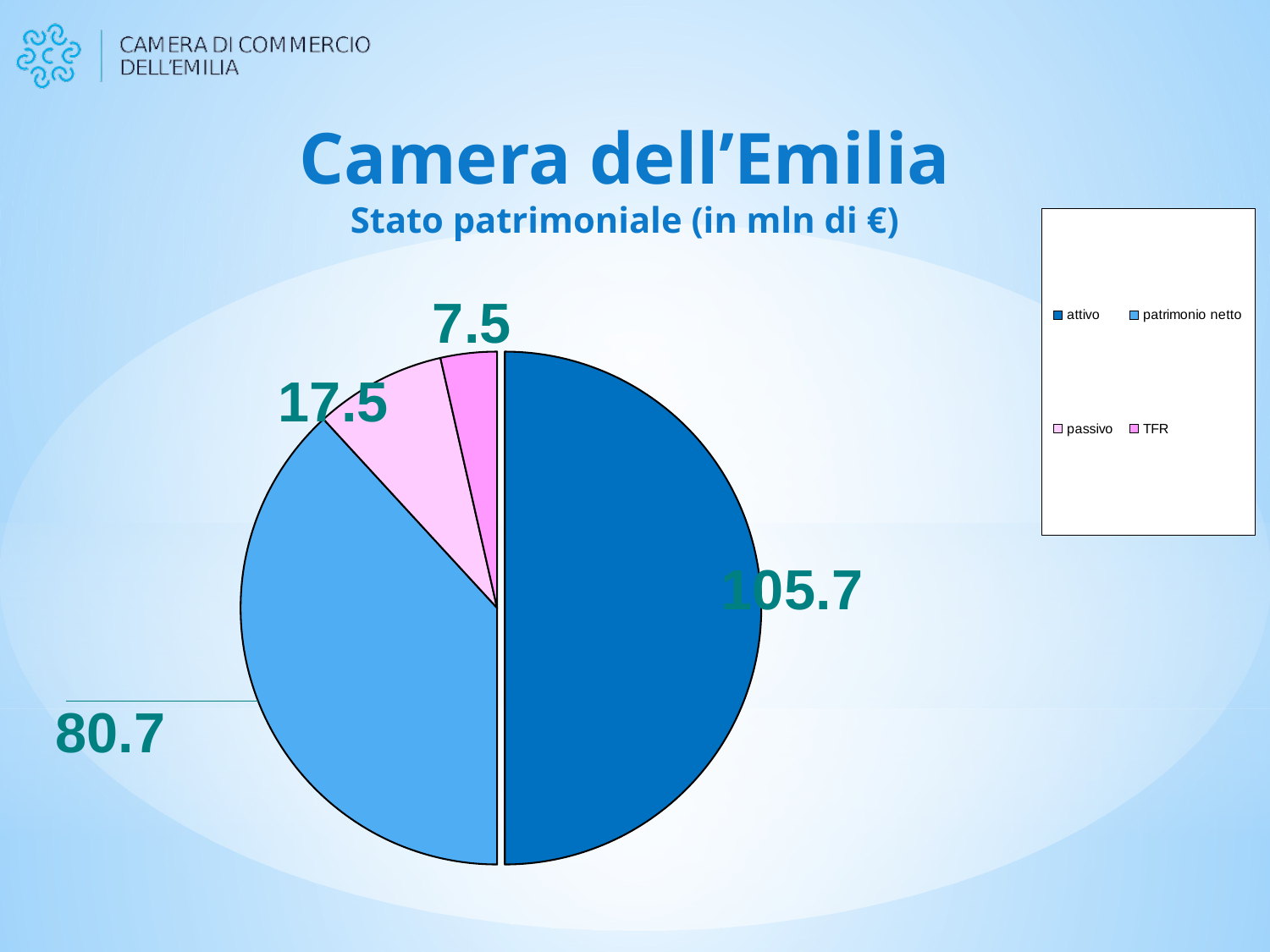
What is the difference between the values for attivo and patrimonio netto? 25 How many slices does the pie chart have? 4 What is the difference between the values for passivo and TFR? 10 Which category has the largest slice of the pie? attivo Which is larger, the value for passivo or the value for TFR? passivo What is the value for passivo? 17.5 What share of the pie does the attivo slice represent? 50% What is the value for patrimonio netto? 80.7 What type of chart is shown on the slide? pie chart Which category has the smallest slice of the pie? TFR What is the value for TFR? 7.5 What is the value for attivo? 105.7